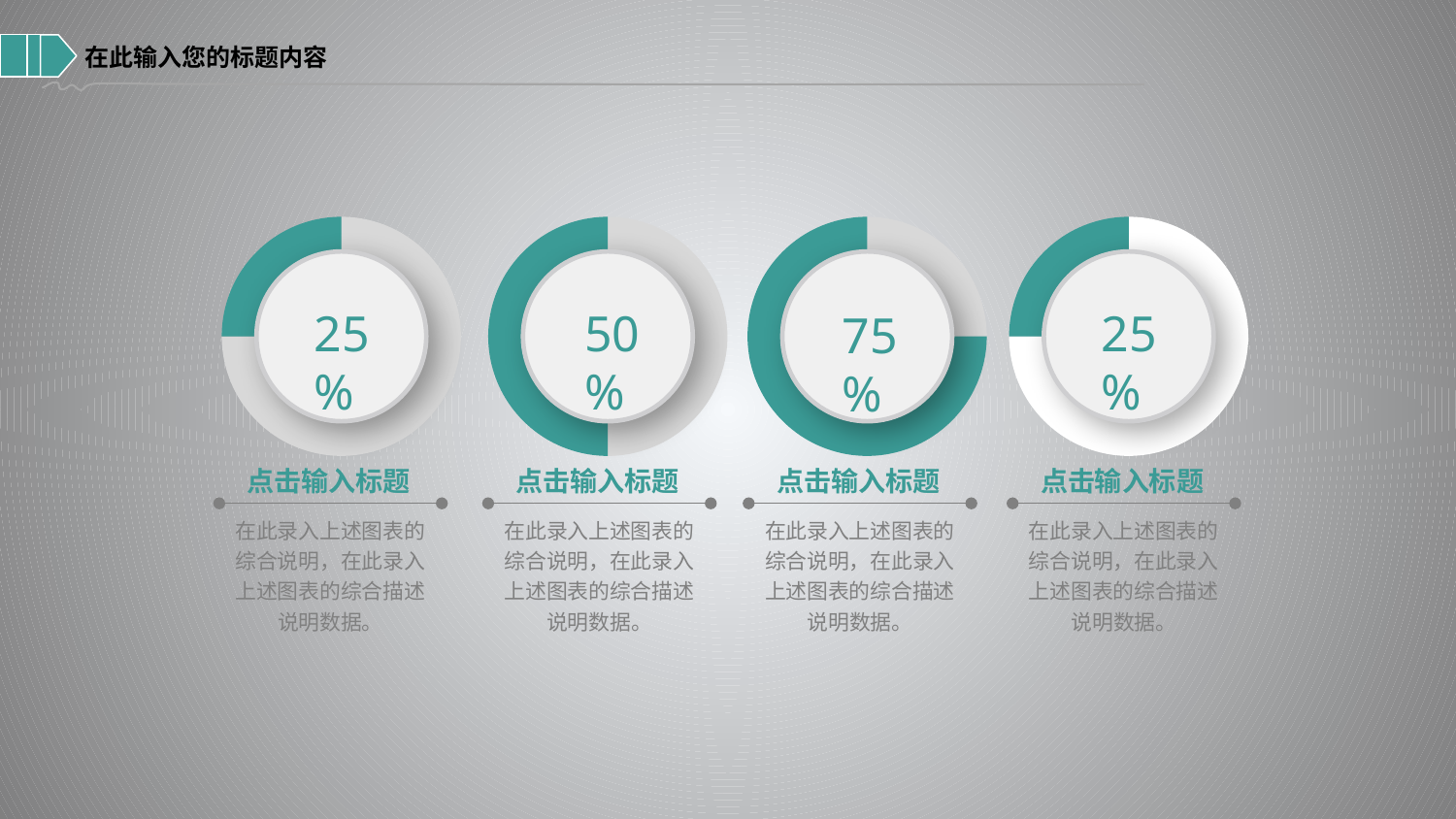
What kind of chart is used to display the percentages on the slide? Ring (donut) chart Do the values rise or fall from the leftmost ring chart to the third ring chart? Rise What value is shown in the second ring chart from the left? 50% What value is shown in the rightmost ring chart? 25% What value is shown in the third ring chart from the left? 75% What value is shown in the leftmost ring chart? 25% What is the difference between the value in the second ring chart and the value in the rightmost ring chart? 25% How many ring charts are shown on the slide? 4 What colour is used for the filled portion of each ring chart? Teal green Which of the four ring charts shows the highest value? The third from the left (75%) What is the difference between the value in the third ring chart and the value in the leftmost ring chart? 50% Which is larger, the value in the second ring chart or the value in the third ring chart? The third ring chart (75%)